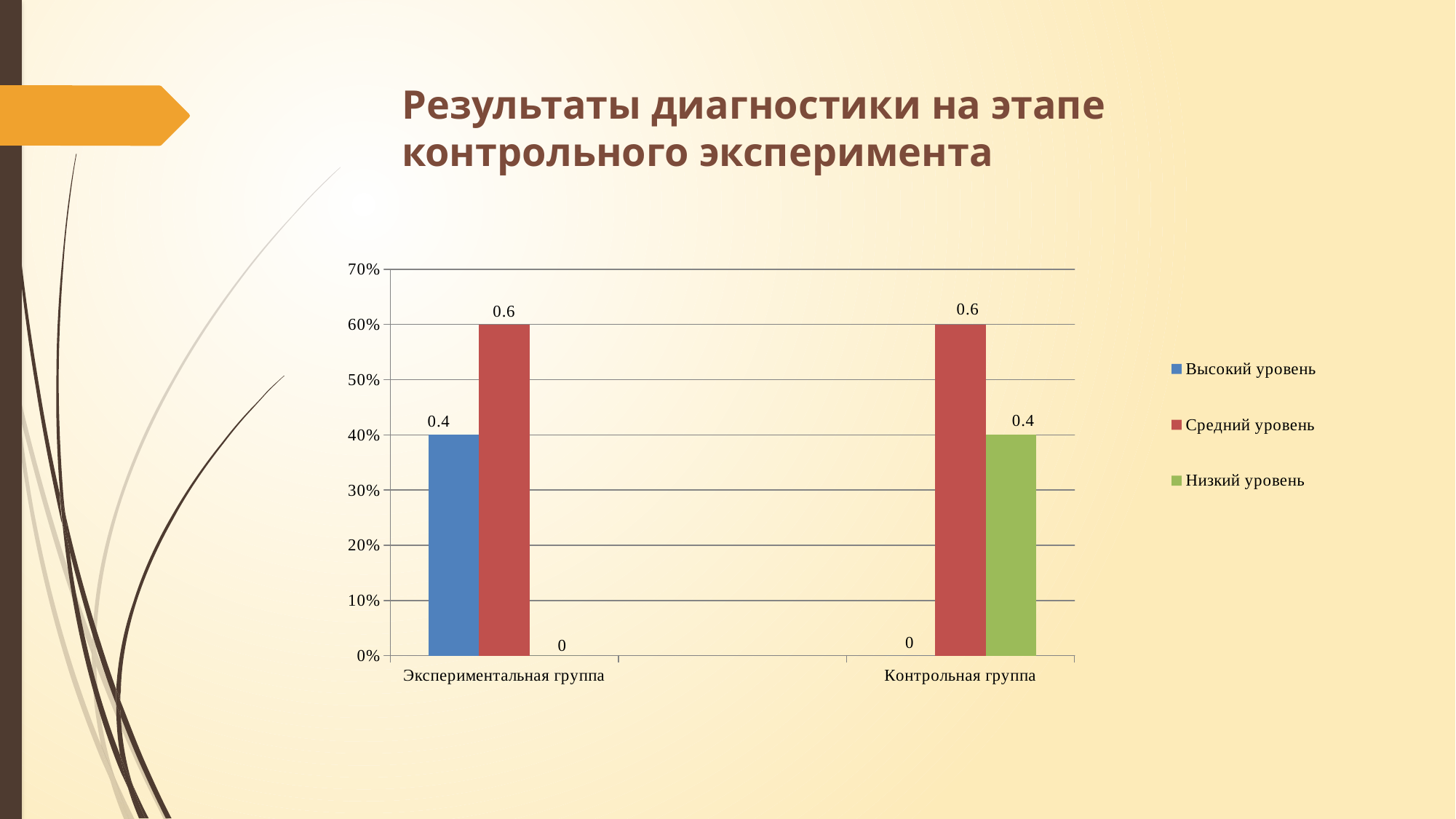
Which series has the lowest value for Контрольная группа? Высокий уровень How many groups are shown on the x axis? 2 What is the value of Низкий уровень for Экспериментальная группа? 0 Which is larger: Низкий уровень for Контрольная группа or Низкий уровень for Экспериментальная группа? Контрольная группа Which series has the highest value for Экспериментальная группа? Средний уровень What is the value of Средний уровень for Контрольная группа? 0.6 What colour represents Средний уровень in the legend? Red What is the value of Высокий уровень for Экспериментальная группа? 0.4 What kind of chart is shown on the slide? Bar chart What is the difference between Средний уровень and Высокий уровень for Экспериментальная группа? 0.2 How many series does the legend list? 3 What is the value of Высокий уровень for Контрольная группа? 0